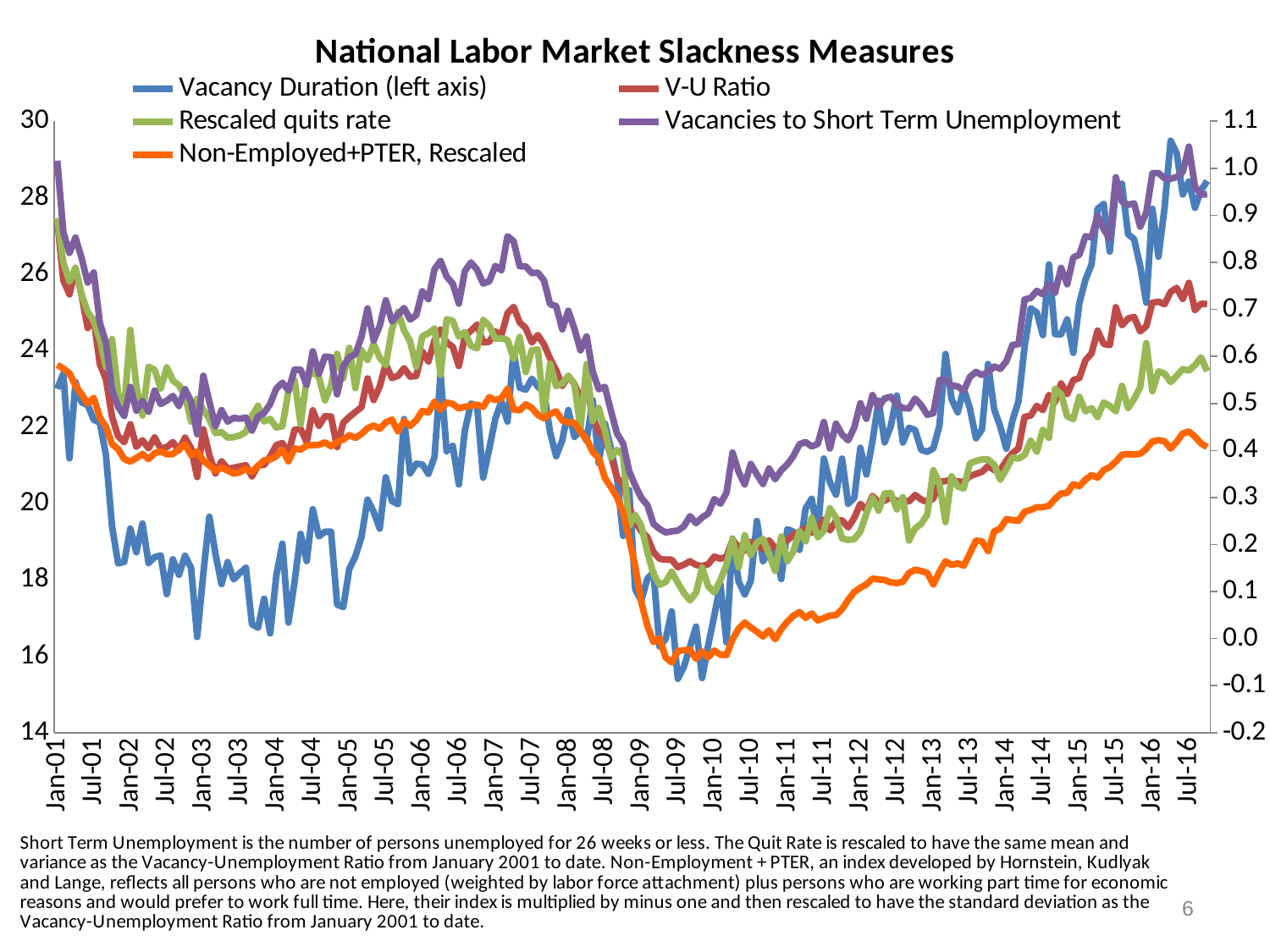
Is the value for V-U Ratio at Jan-10 greater or less than 0.3? less Is the value for Vacancy Duration at Jan-01 greater or less than 20? greater Is the value for Non-Employed+PTER, Rescaled at Jul-16 greater or less than 0.3? greater What is the title of the chart? National Labor Market Slackness Measures At Jul-16, which is higher: Vacancies to Short Term Unemployment or V-U Ratio? Vacancies to Short Term Unemployment How many series does the legend list? 5 Does the Vacancy Duration series rise or fall from Jan-08 to Jul-09? fall Does the Non-Employed+PTER, Rescaled series rise or fall from Jan-10 to Jul-16? rise What kind of chart is shown on the slide? Line chart Which series is plotted against the left axis? Vacancy Duration